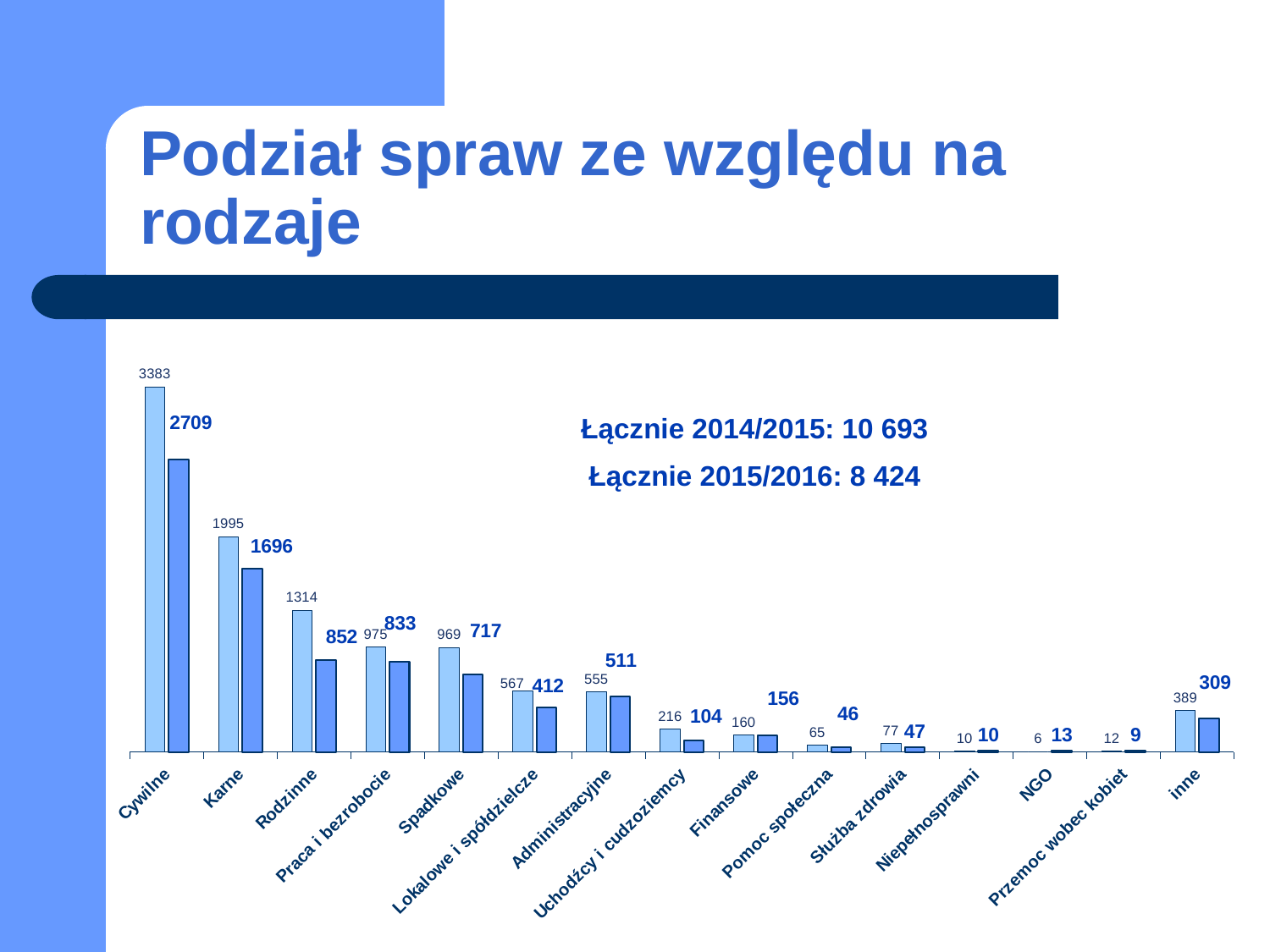
Which category has the lowest light blue (first) bar? NGO Which category has the highest light blue (first) bar? Cywilne How many categories are shown on the x axis of the chart? 15 What is the value of the dark blue (second) bar for Karne? 1696 Which is larger for NGO: the light blue (first) bar or the dark blue (second) bar? the dark blue (second) bar What is the value of the light blue (first) bar for inne? 389 What is the value of the light blue (first) bar for Cywilne? 3383 What total is given on the slide for 2015/2016? 8 424 What is the difference between the light blue and dark blue bars for Rodzinne? 462 What is the difference between the two totals printed on the slide, 2014/2015 and 2015/2016? 2 269 What type of chart is shown on the slide? bar chart What is the value of the dark blue (second) bar for Administracyjne? 511